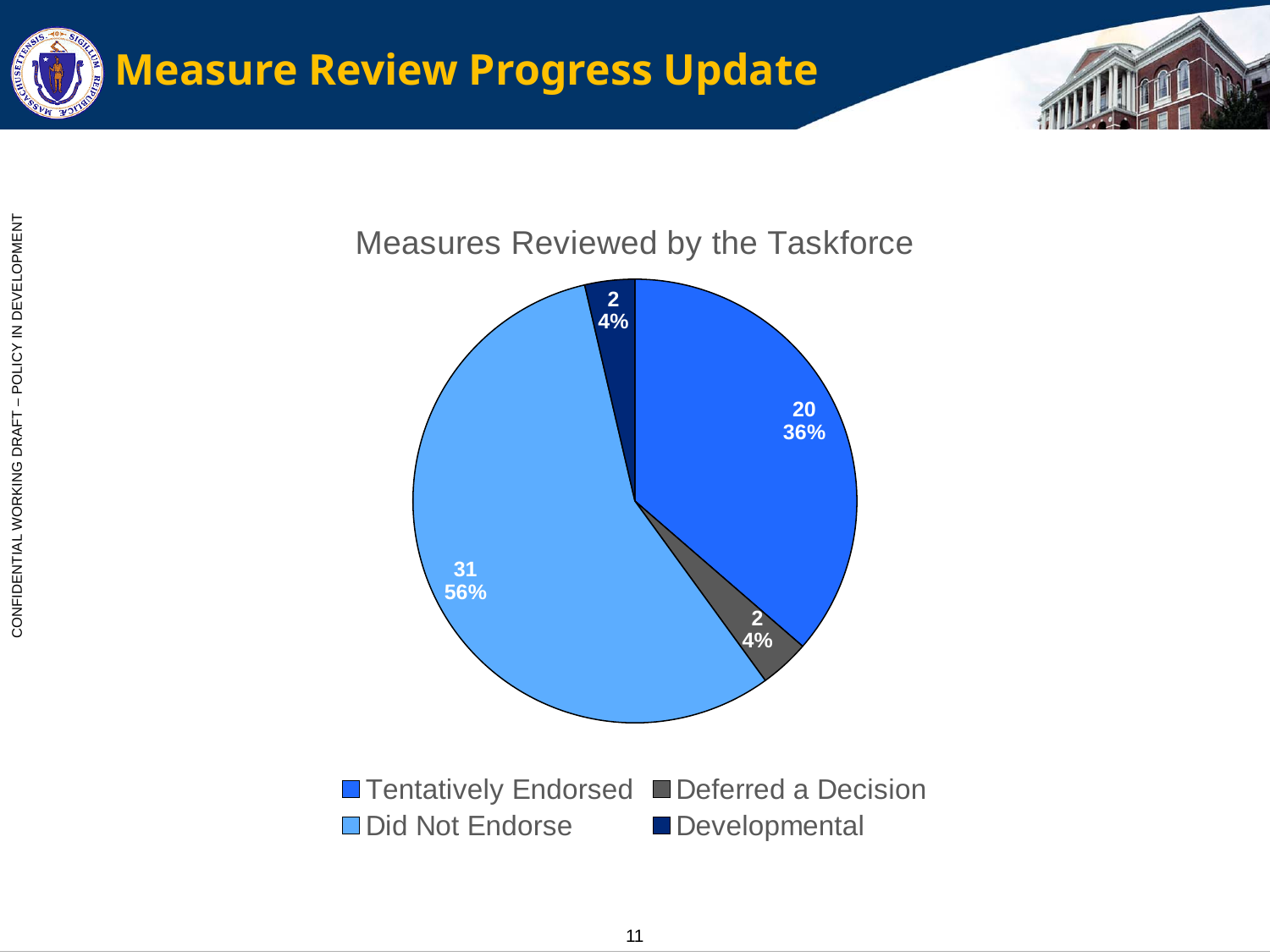
Which is larger, the Tentatively Endorsed slice or the Deferred a Decision slice? Tentatively Endorsed Which category has the largest slice of the pie? Did Not Endorse What is the difference between the number of Did Not Endorse measures and Tentatively Endorsed measures? 11 What is the title of the chart? Measures Reviewed by the Taskforce What percentage of measures are Developmental? 4% What type of chart is shown on the slide? Pie chart What share of the pie does Did Not Endorse represent? 56% How many categories does the legend list? 4 What is the total number of measures shown across all slices? 55 How many measures fall under Did Not Endorse? 31 How many measures were Tentatively Endorsed? 20 What percentage of measures were Tentatively Endorsed? 36%